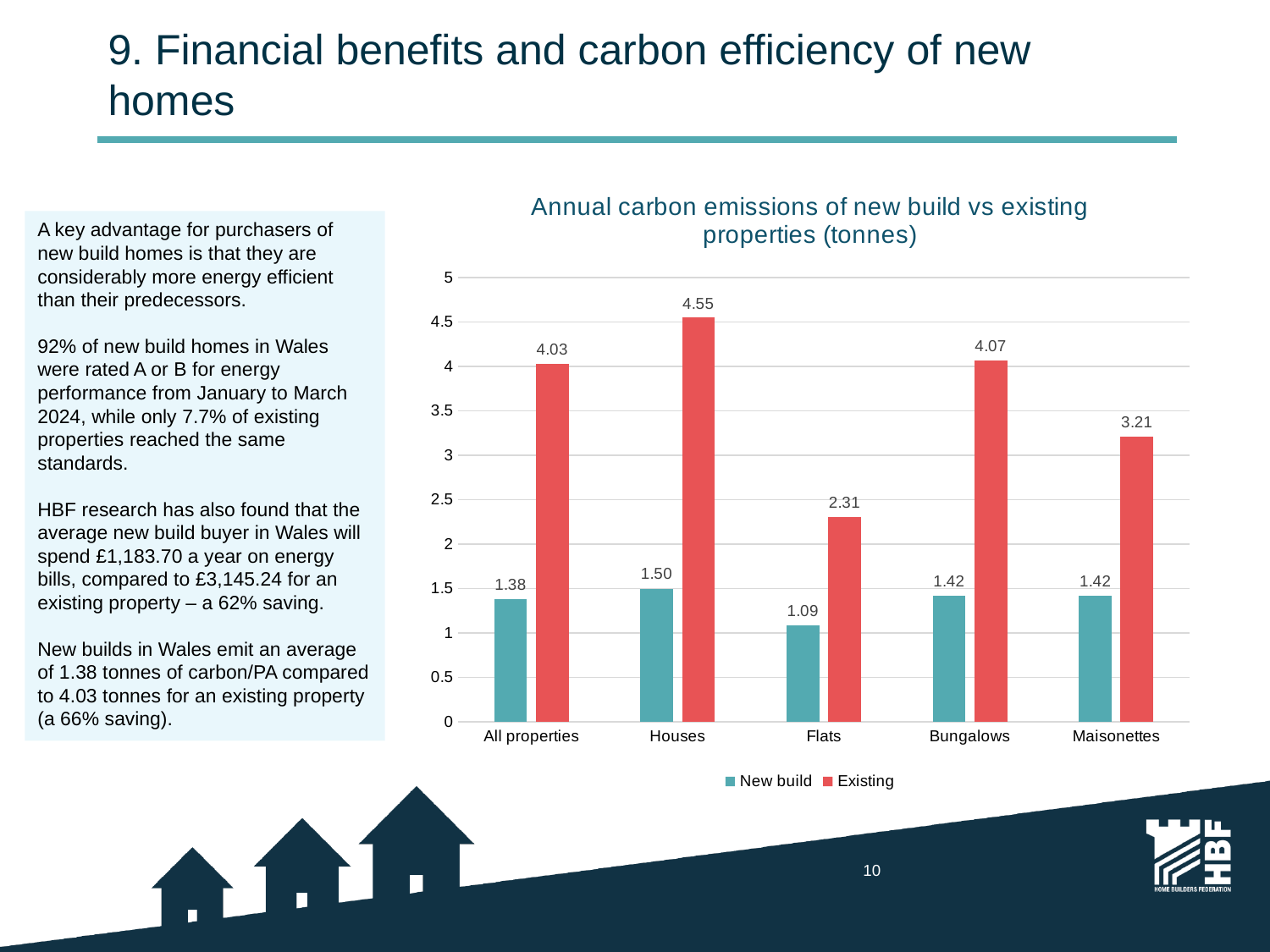
What is the difference between the Existing and New build values for All properties? 2.65 Which category has the highest Existing value? Houses Is the Existing value for Flats greater or less than 2? greater How many series does the legend list? 2 What is the New build value for Flats? 1.09 What is the Existing value for Houses? 4.55 Which is larger: the Existing value for Bungalows or the Existing value for Maisonettes? Bungalows Which category has the lowest New build value? Flats What is the title of the chart? Annual carbon emissions of new build vs existing properties (tonnes) What kind of chart is shown on the slide? Bar chart How many categories are shown on the x axis? 5 What is the Existing value for Maisonettes? 3.21